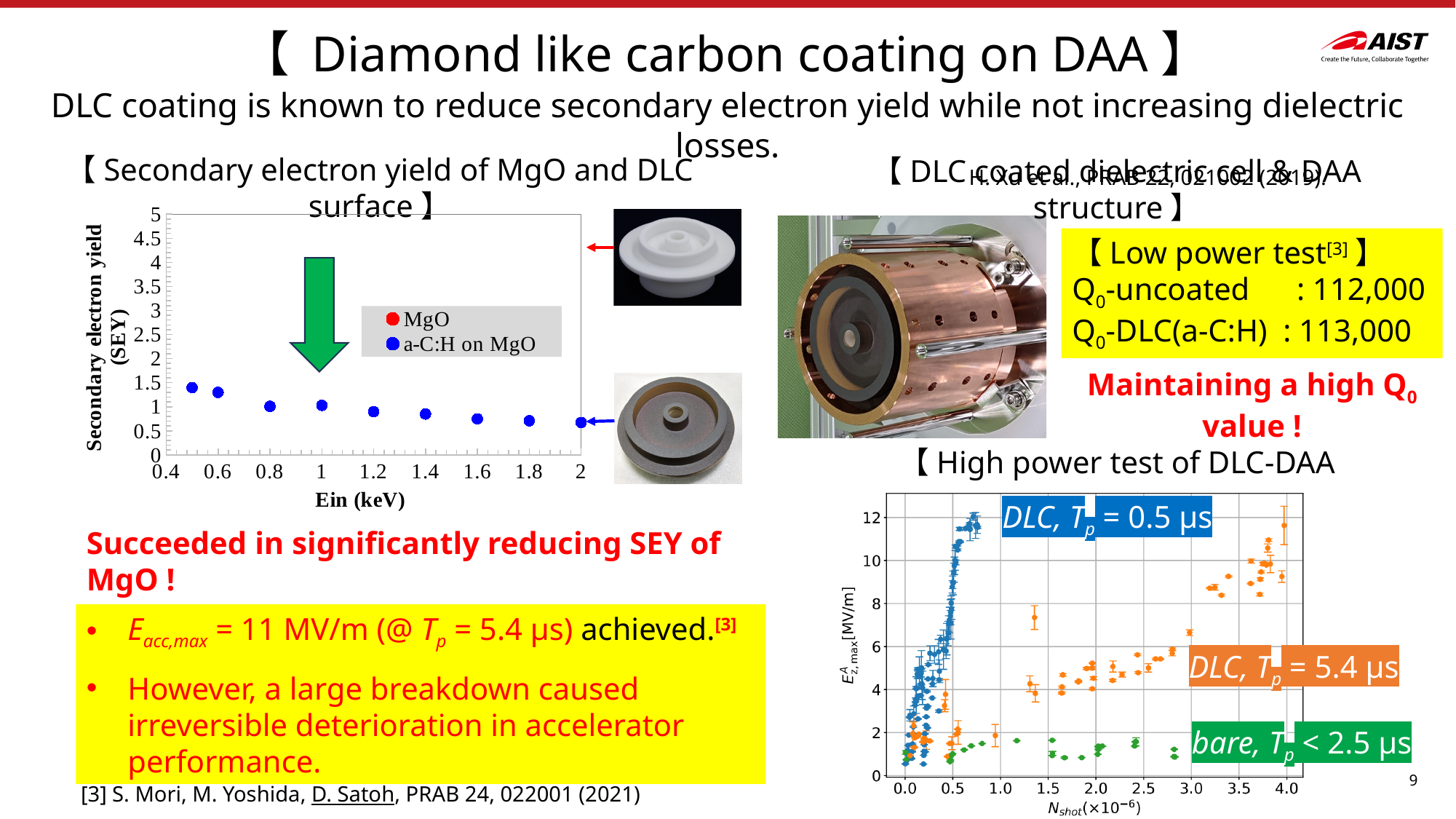
In the 'Secondary electron yield of MgO and DLC surface' chart, is the a-C:H on MgO value at Ein = 2 keV greater or less than 1? less In the 'High power test of DLC-DAA' chart, is the highest value of the DLC, Tp = 0.5 µs series greater or less than 10 MV/m? greater What is the label of the x axis of the 'High power test of DLC-DAA' chart? N_shot (×10^-6) In the 'Secondary electron yield of MgO and DLC surface' chart, do the a-C:H on MgO values rise or fall as Ein increases? fall What kind of chart is the 'Secondary electron yield of MgO and DLC surface' chart? scatter chart How many a-C:H on MgO data points are plotted in the 'Secondary electron yield of MgO and DLC surface' chart? 9 In the 'Secondary electron yield of MgO and DLC surface' chart, is the a-C:H on MgO value at Ein = 0.5 keV greater or less than 1? greater In the 'High power test of DLC-DAA' chart, which series has the lowest values? bare, Tp < 2.5 µs How many series does the legend of the 'Secondary electron yield of MgO and DLC surface' chart list? 2 In the 'Secondary electron yield of MgO and DLC surface' chart, which series is plotted in blue? a-C:H on MgO How many series are shown in the 'High power test of DLC-DAA' chart? 3